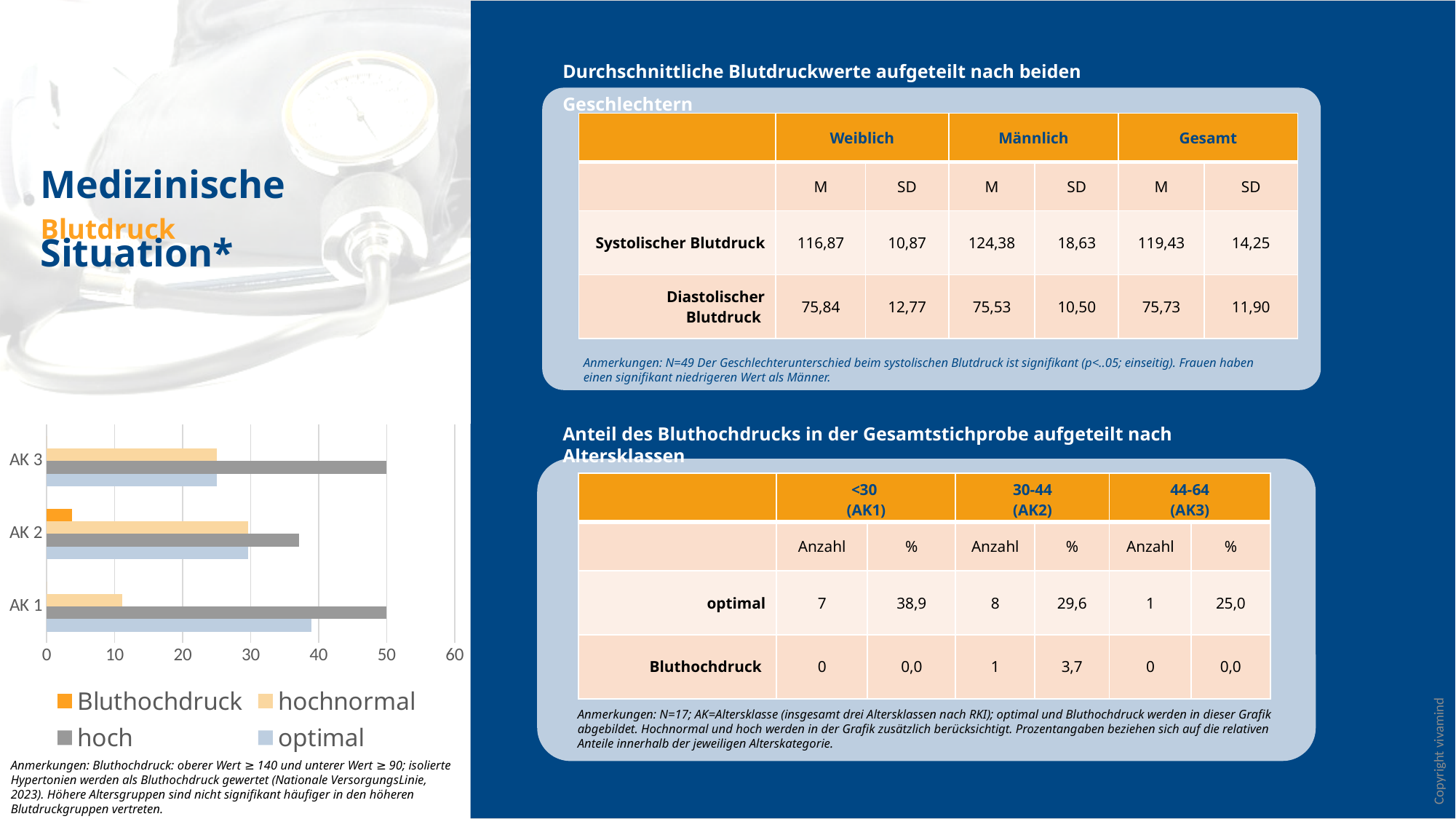
In the bar chart, which series has the longest bar for AK 2? hoch In the bar chart, is the value for 'optimal' in AK 1 greater or less than 30? greater In the bar chart, which series has the shortest visible bar for AK 1? hochnormal What is the highest tick value shown on the x axis of the bar chart? 60 In the bar chart, is the 'optimal' value larger for AK 1 or for AK 2? AK 1 In the bar chart, is the value for 'Bluthochdruck' in AK 2 greater or less than 10? less How many age-class categories (AK) does the bar chart show? 3 In the bar chart, is the 'hoch' value larger for AK 2 or for AK 3? AK 3 How many series does the legend of the bar chart list? 4 What kind of chart is shown on the left of the slide? bar chart In the bar chart, is the value for 'hoch' in AK 1 greater or less than 40? greater